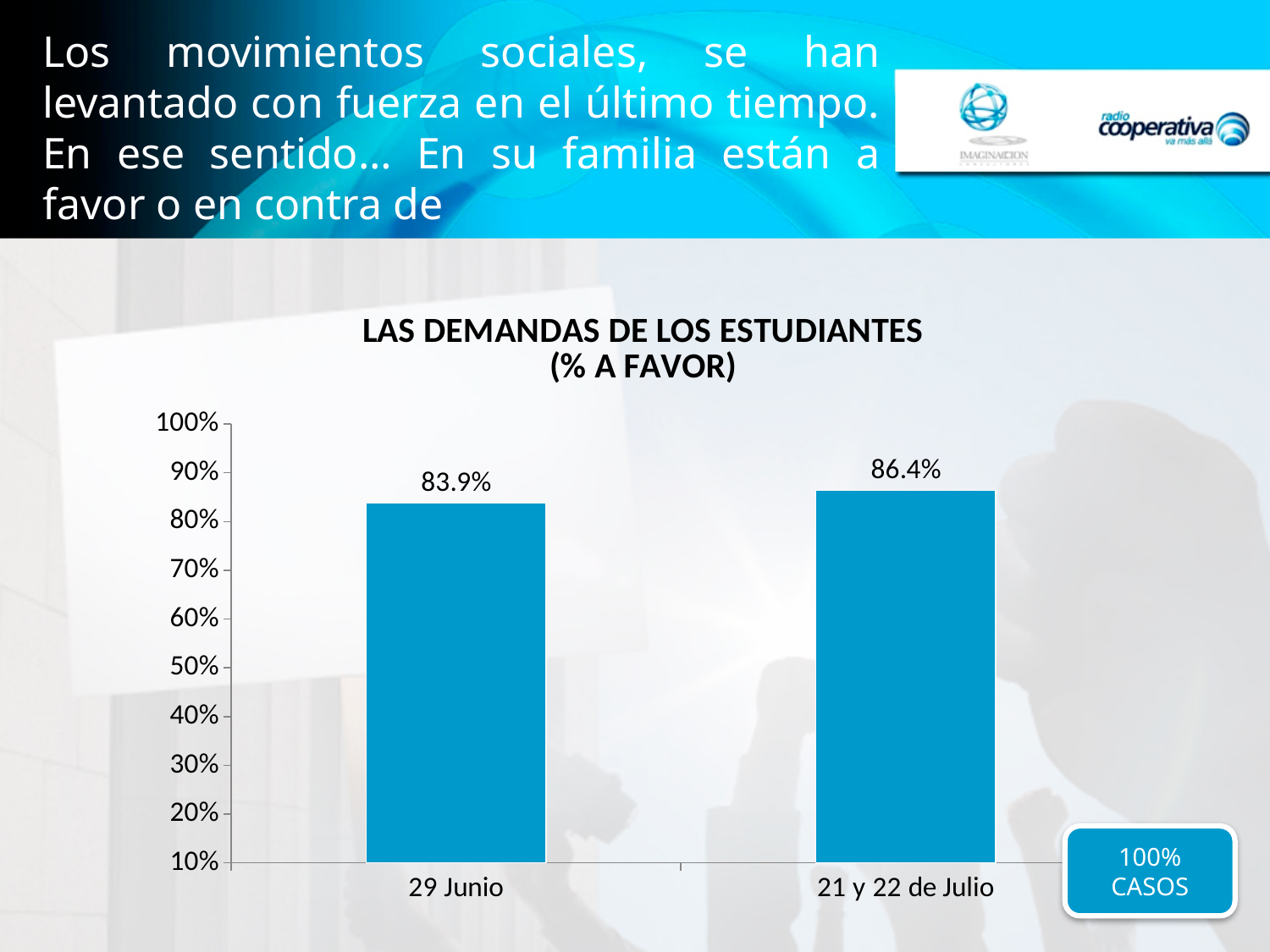
What kind of chart is shown on the slide? bar chart Which category has the lowest value? 29 Junio Do the values rise or fall from 29 Junio to 21 y 22 de Julio? rise Is the value for 29 Junio greater or less than 80%? greater What is the value for 21 y 22 de Julio? 86.4% How many categories are shown on the x axis? 2 What is the value for 29 Junio? 83.9% Which is larger, the value for 29 Junio or the value for 21 y 22 de Julio? 21 y 22 de Julio Which category has the highest value? 21 y 22 de Julio What is the title of the chart? LAS DEMANDAS DE LOS ESTUDIANTES (% A FAVOR) What is the difference between the values for 21 y 22 de Julio and 29 Junio? 2.5% Is the value for 21 y 22 de Julio greater or less than 90%? less